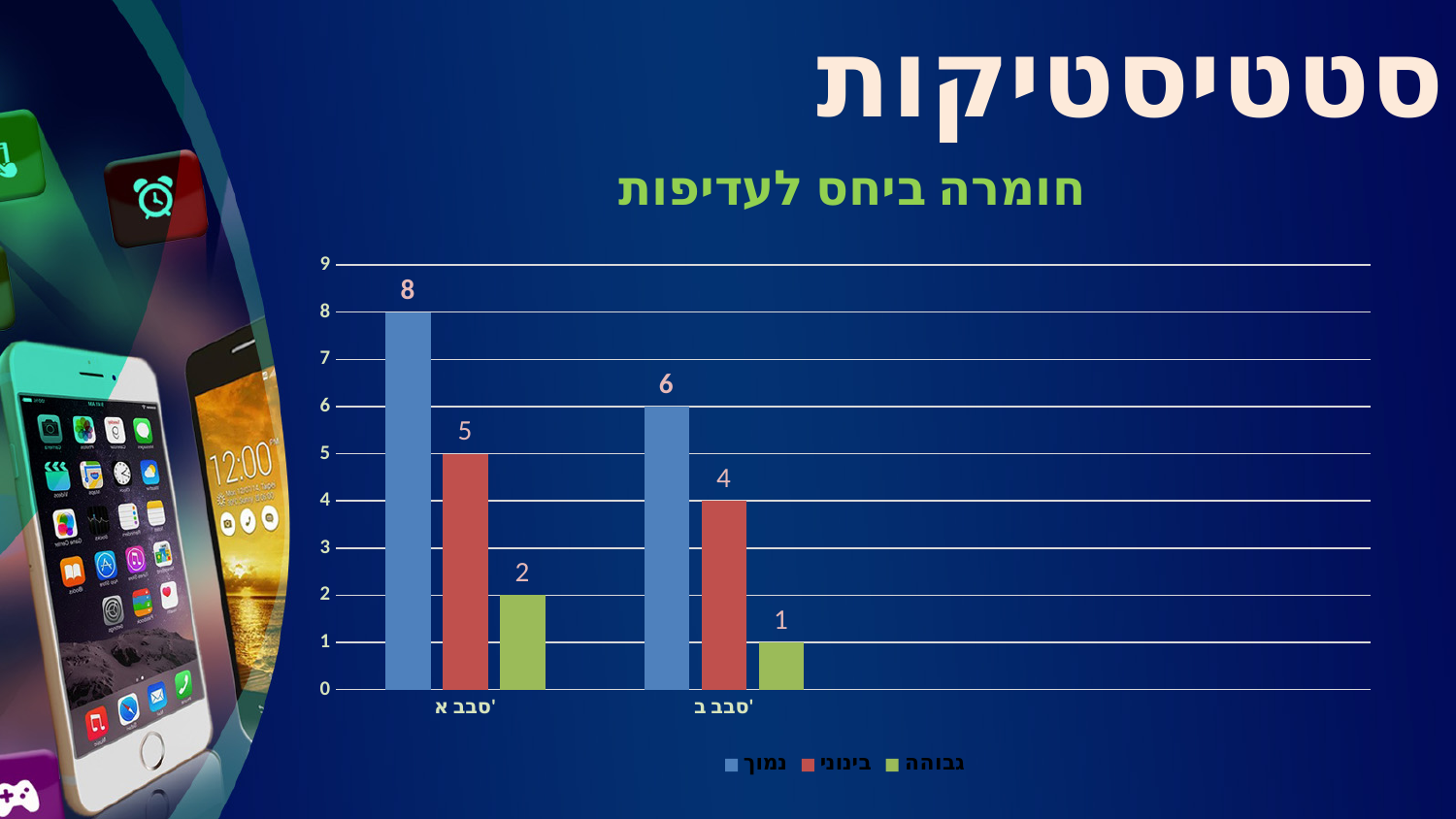
What is the difference between the נמוך values for סבב א' and סבב ב'? 2 What is the value of the גבוהה series for סבב א'? 2 Which series has the highest value for סבב ב'? נמוך What is the value of the נמוך series for סבב א'? 8 What kind of chart is shown on the slide? bar chart Which is larger: the בינוני value for סבב א' or the בינוני value for סבב ב'? סבב א' How many categories are shown on the x axis? 2 What is the title of the chart? חומרה ביחס לעדיפות How many series does the legend list? 3 Is the נמוך value for סבב ב' greater or less than 5? greater What is the value of the בינוני series for סבב ב'? 4 Which series has the lowest value for סבב א'? גבוהה